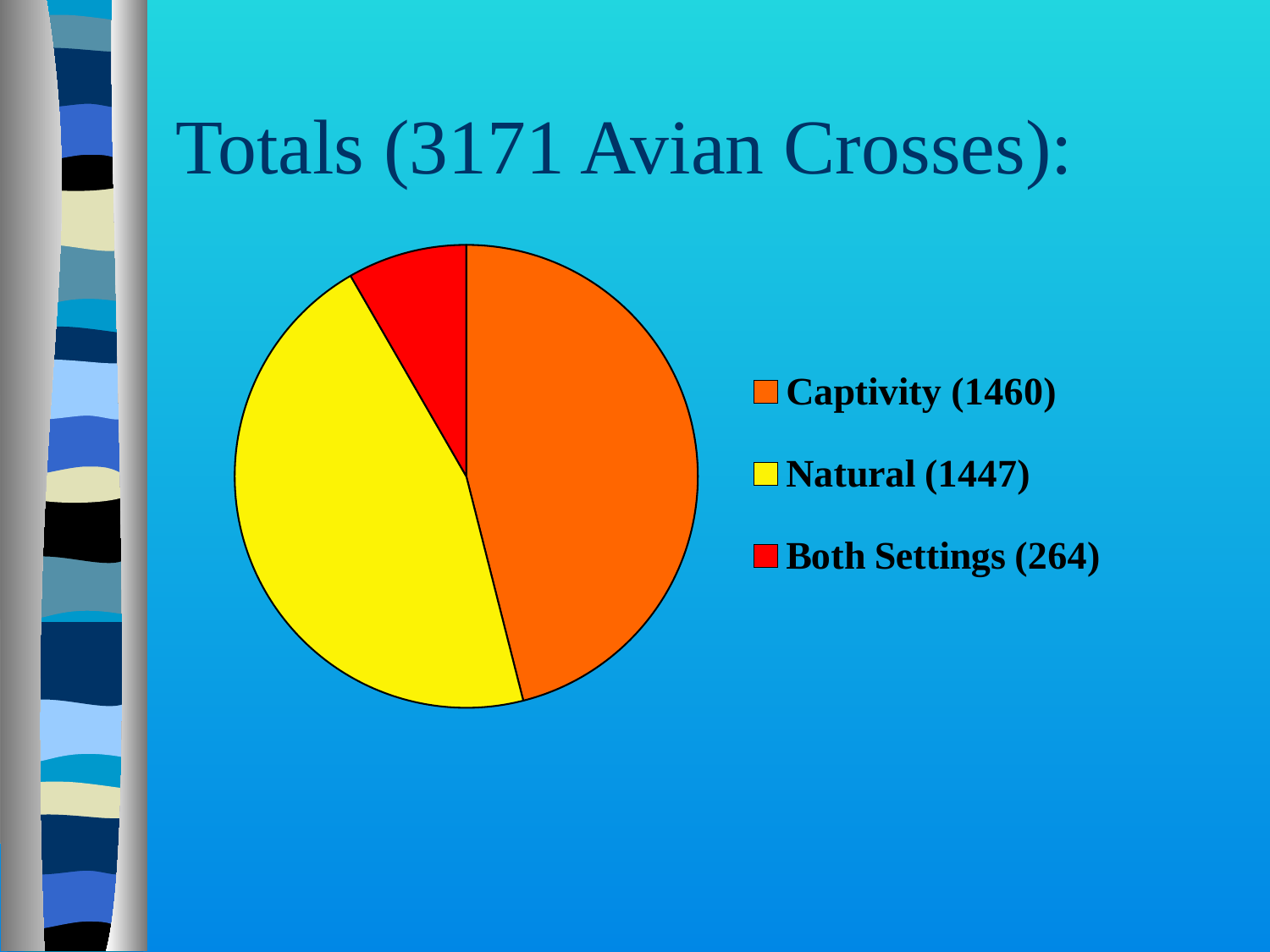
What is the difference between the Natural and Both Settings values? 1183 What is the difference between the Captivity and Natural values? 13 What kind of chart is shown on the slide? Pie chart What is the value for Both Settings? 264 What colour is the slice for Both Settings? Red Which is larger, the value for Natural or the value for Both Settings? Natural What is the value for Natural? 1447 Which category has the smallest slice of the pie? Both Settings How many entries does the legend list? 3 Which category has the largest value according to the legend? Captivity What is the value for Captivity? 1460 How many slices does the pie chart have? 3